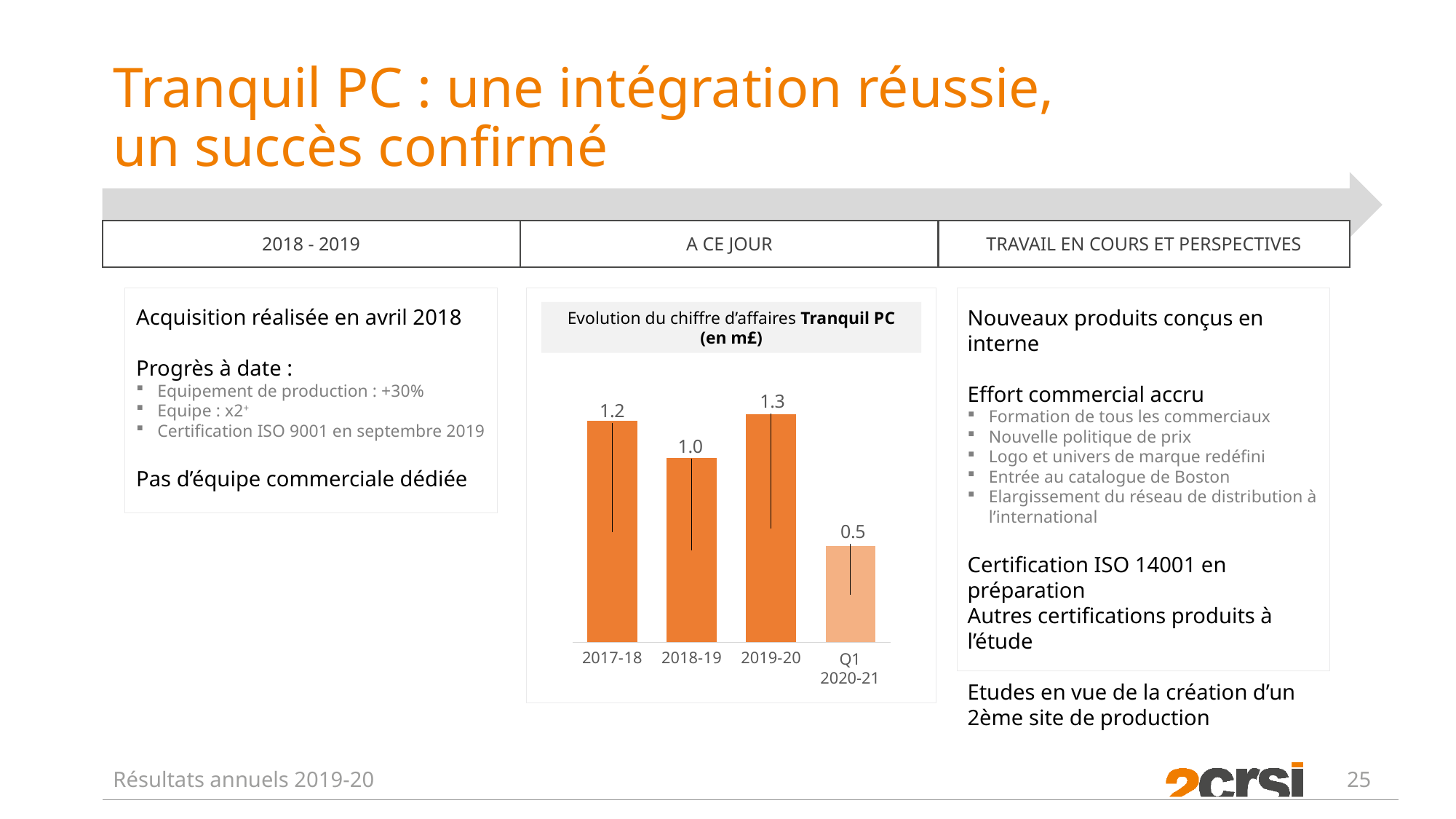
What kind of chart is shown on the slide? Bar chart What is the difference between the values for 2017-18 and Q1 2020-21? 0.7 What is the value for 2019-20 in the chart? 1.3 Which category has the lowest value in the chart? Q1 2020-21 What is the value for Q1 2020-21 in the chart? 0.5 What is the value for 2017-18 in the chart? 1.2 How many categories are shown in the chart? 4 Which category has the highest value in the chart? 2019-20 What is the value for 2018-19 in the chart? 1.0 Which is larger, the value for 2017-18 or the value for 2018-19? 2017-18 What is the title of the chart? Evolution du chiffre d'affaires Tranquil PC (en m£) What is the difference between the values for 2019-20 and 2018-19? 0.3